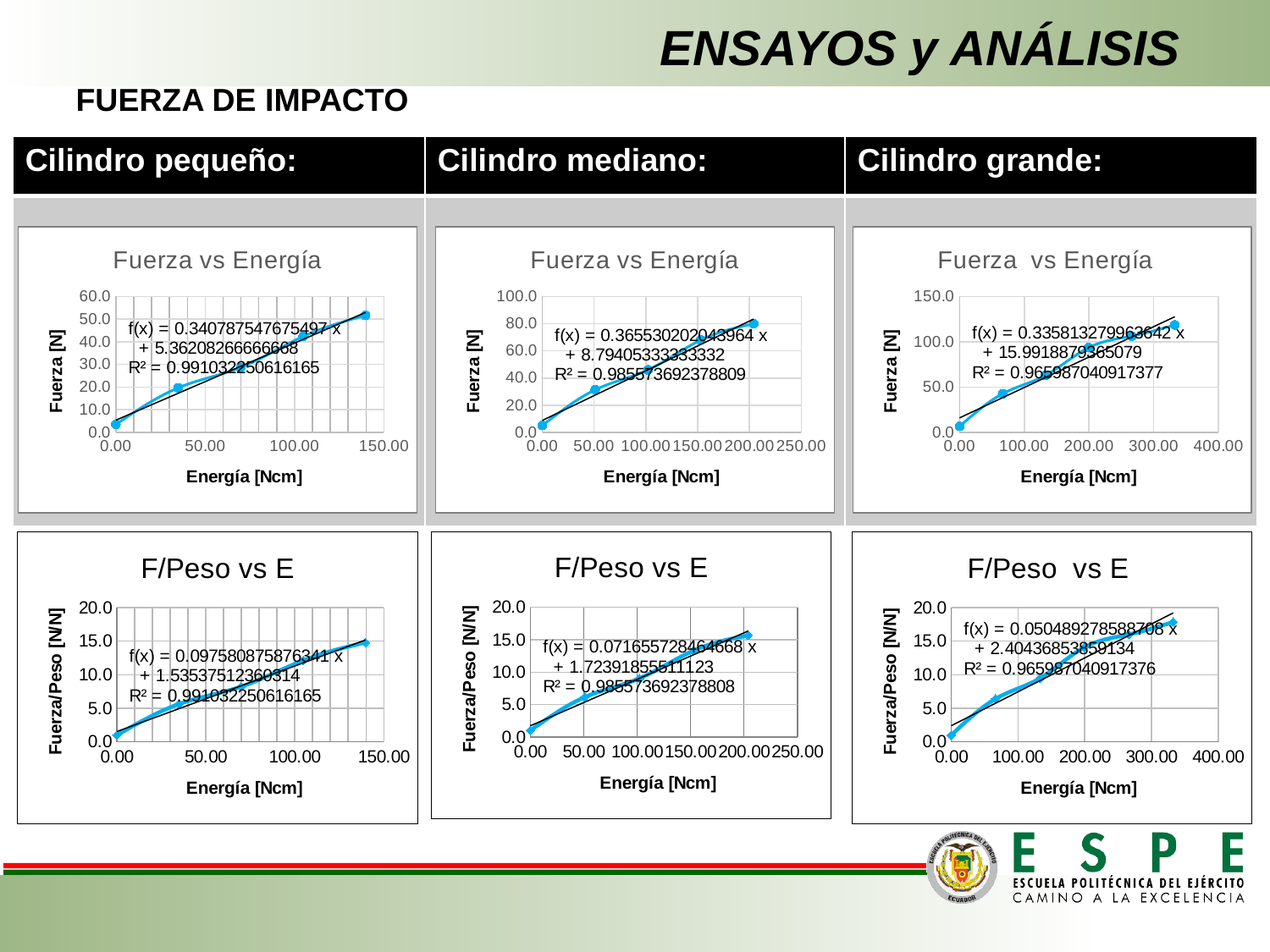
What is the x-axis title of the 'Fuerza vs Energía' chart under 'Cilindro pequeño'? Energía [Ncm] What R² value is shown on the 'Fuerza vs Energía' chart under 'Cilindro pequeño'? R² = 0.991032250616165 In the 'Fuerza vs Energía' chart under 'Cilindro grande', is the highest plotted Fuerza value greater or less than 100.0? greater What kind of chart is the 'Fuerza vs Energía' chart under 'Cilindro pequeño'? Line chart (scatter with trendline) In the 'Fuerza vs Energía' chart under 'Cilindro mediano', is the highest plotted Fuerza value greater or less than 60.0? greater In the 'F/Peso vs E' chart under 'Cilindro pequeño', is the highest plotted Fuerza/Peso value greater or less than 10.0? greater How many charts are shown on the slide? 6 In the 'Fuerza vs Energía' chart under 'Cilindro grande', do the values rise or fall as Energía increases? Rise In the 'F/Peso vs E' chart under 'Cilindro mediano', do the values rise or fall along the x axis? Rise